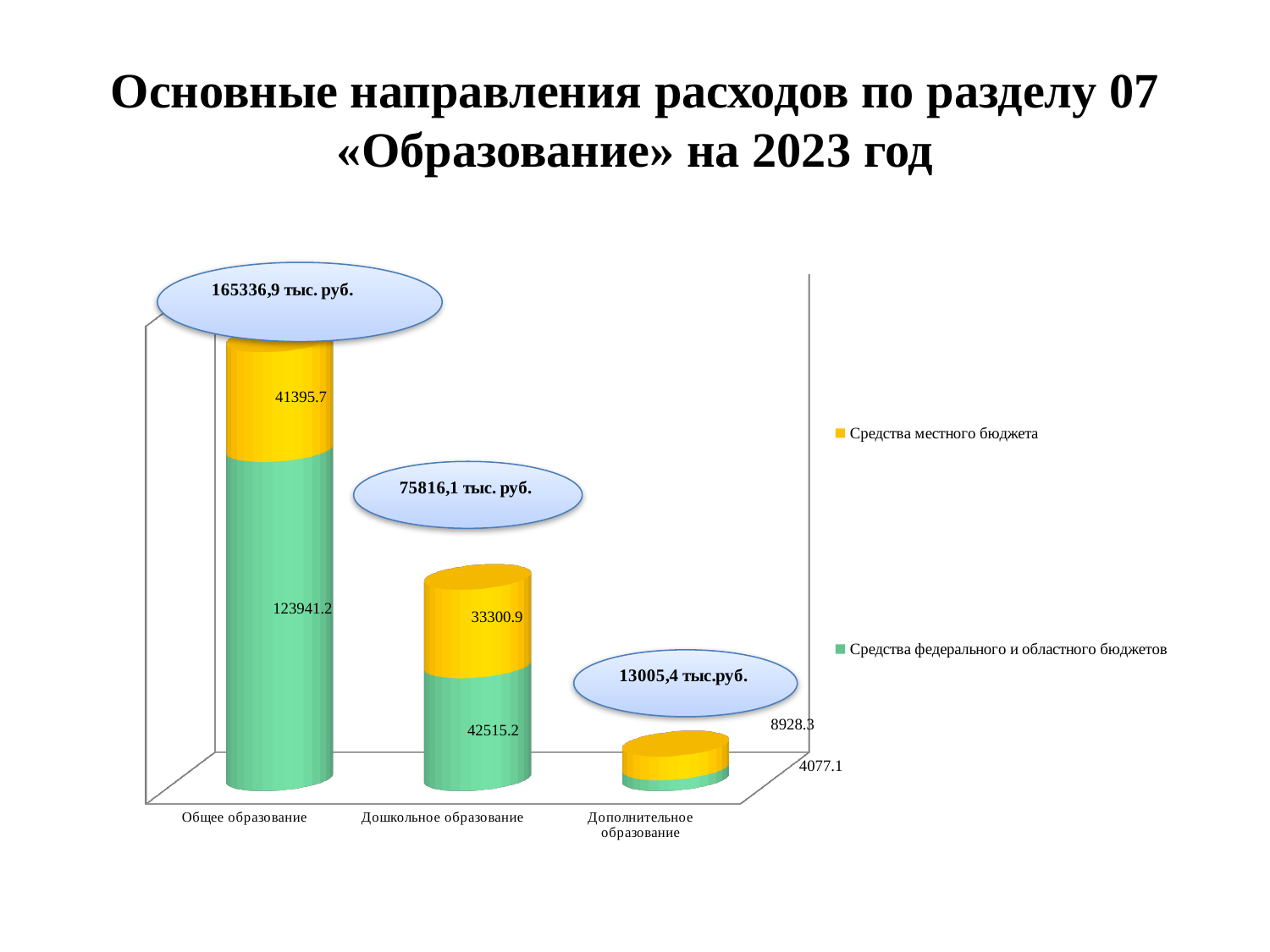
What is the value of Средства местного бюджета for Общее образование? 41395.7 What is the total shown for the Дополнительное образование bar? 13005,4 тыс.руб. How many series does the legend list? 2 Which category has the highest total expenditure? Общее образование What is the total shown for the Дошкольное образование bar? 75816,1 тыс. руб. How many categories are shown on the x axis of the chart? 3 What is the difference between Средства федерального и областного бюджетов and Средства местного бюджета for Дошкольное образование? 9214.3 What is the value of Средства местного бюджета for Дошкольное образование? 33300.9 Which category has the lowest total expenditure? Дополнительное образование What kind of chart is shown on the slide? stacked bar chart What is the value of Средства федерального и областного бюджетов for Общее образование? 123941.2 What is the value of Средства федерального и областного бюджетов for Дополнительное образование? 4077.1